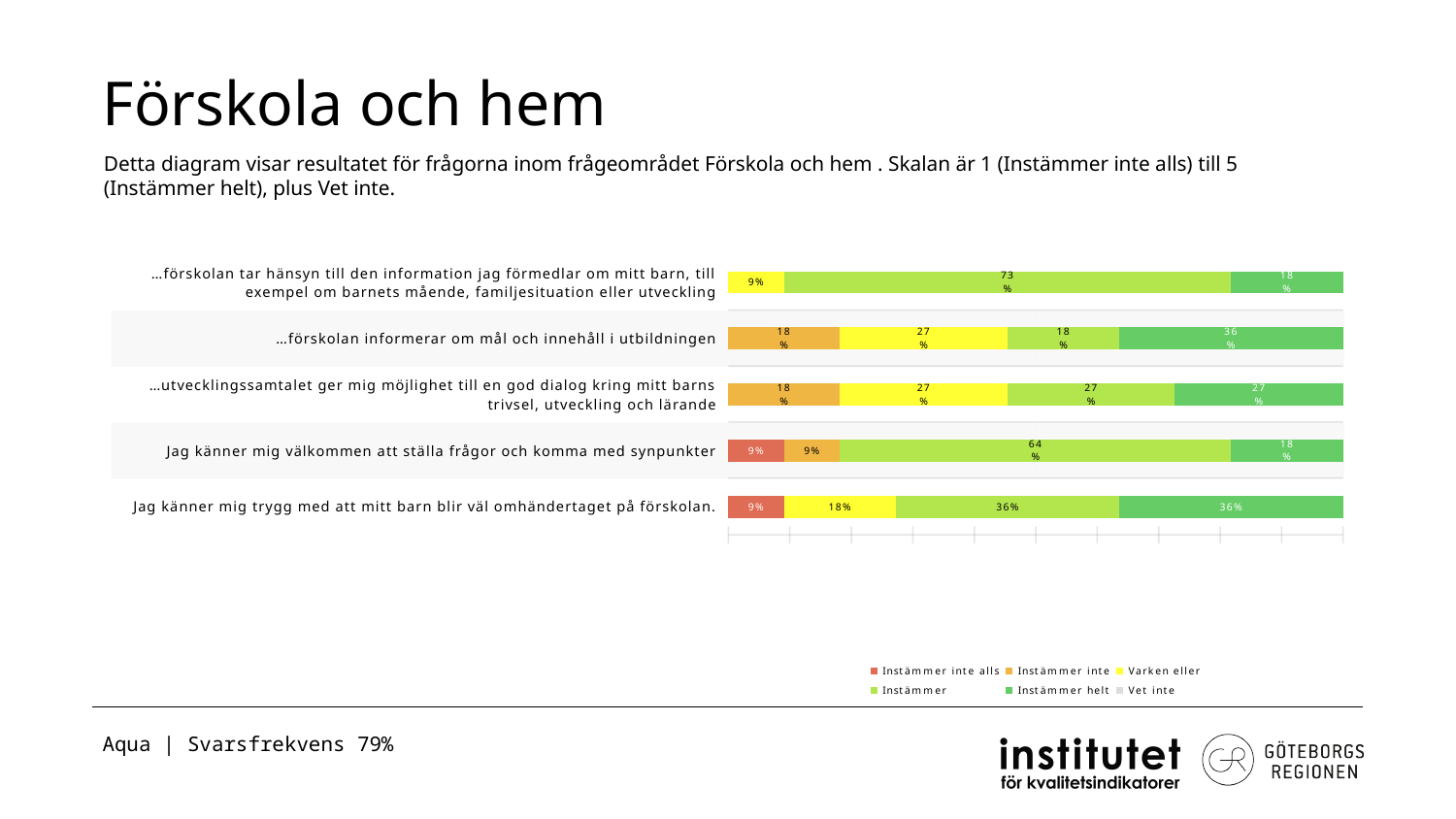
What is the 'Instämmer inte' share for '…utvecklingssamtalet ger mig möjlighet till en god dialog kring mitt barns trivsel, utveckling och lärande'? 18% How many series does the legend list? 6 Which legend entry is shown in red? Instämmer inte alls Which question has the lowest 'Instämmer' share? …förskolan informerar om mål och innehåll i utbildningen How many questions (categories) are plotted in the chart? 5 Which has the larger 'Instämmer' share: 'Jag känner mig trygg med att mitt barn blir väl omhändertaget på förskolan' or 'Jag känner mig välkommen att ställa frågor och komma med synpunkter'? Jag känner mig välkommen att ställa frågor och komma med synpunkter What is the difference in 'Instämmer helt' share between '…förskolan informerar om mål och innehåll i utbildningen' and '…förskolan tar hänsyn till den information jag förmedlar om mitt barn…'? 18 percentage points Which question has the highest 'Instämmer' share? …förskolan tar hänsyn till den information jag förmedlar om mitt barn, till exempel om barnets mående, familjesituation eller utveckling What is the 'Instämmer helt' share for '…förskolan informerar om mål och innehåll i utbildningen'? 36% What is the 'Instämmer' share for '…förskolan tar hänsyn till den information jag förmedlar om mitt barn, till exempel om barnets mående, familjesituation eller utveckling'? 73% What is the 'Instämmer' share for 'Jag känner mig välkommen att ställa frågor och komma med synpunkter'? 64% What kind of chart is shown on the slide? bar chart